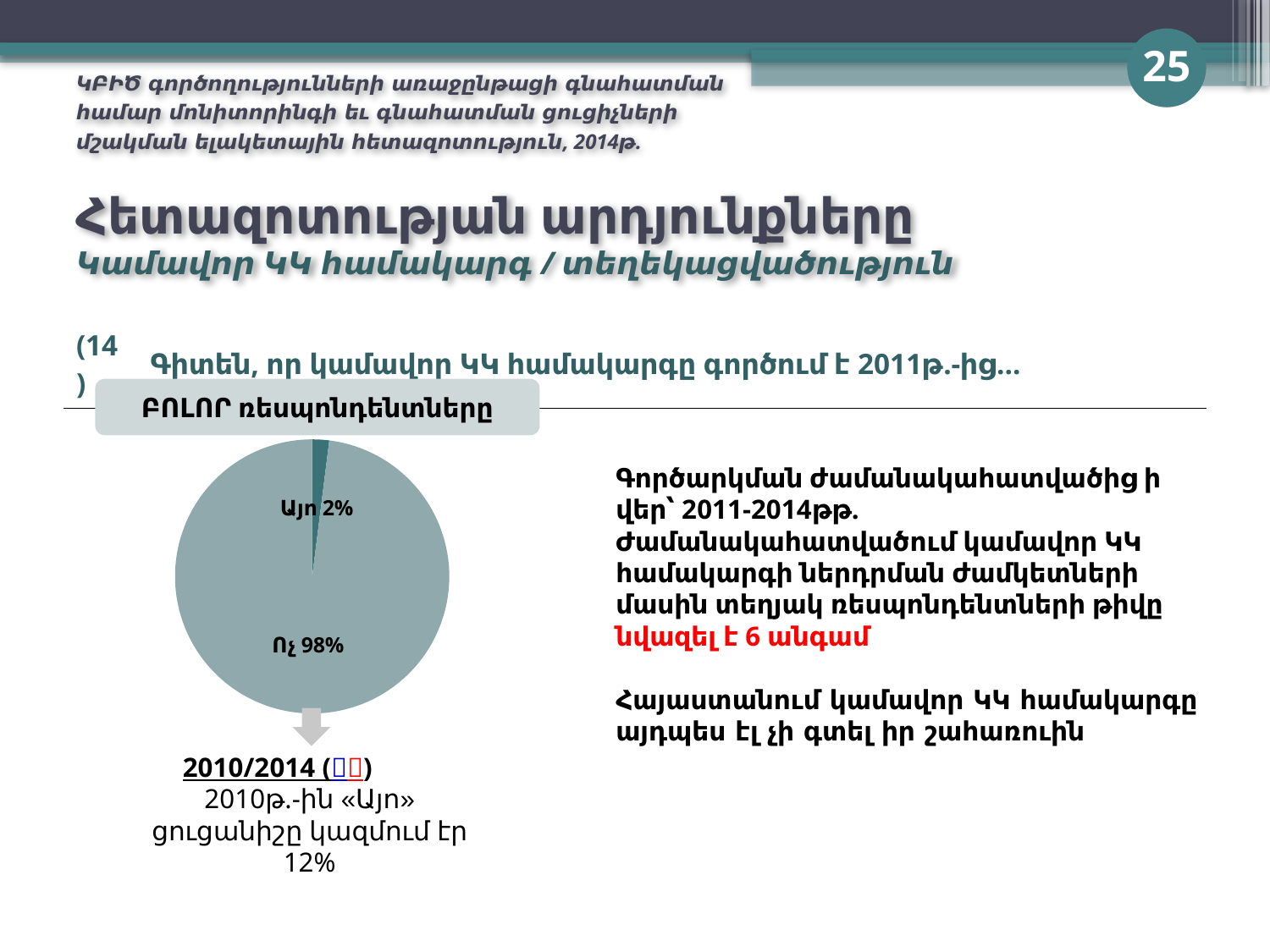
What percentage is shown for the "Ոչ" slice of the pie chart? 98% What percentage is shown for the "Այո" slice of the pie chart? 2% Which slice of the pie chart is the largest? Ոչ What kind of chart is shown on the slide? pie chart What label appears in the box above the pie chart? ԲՈԼՈՐ ռեսպոնդենտները Which slice of the pie chart is the smallest? Այո According to the text below the pie chart, what was the "Այո" value in 2010? 12% What is the difference in percentage points between the "Ոչ" and "Այո" slices? 96 Is the value for "Ոչ" greater or less than 50%? greater What share of the pie does the "Այո" slice represent? 2% How many slices does the pie chart have? 2 Which is larger in the pie chart, "Այո" or "Ոչ"? Ոչ